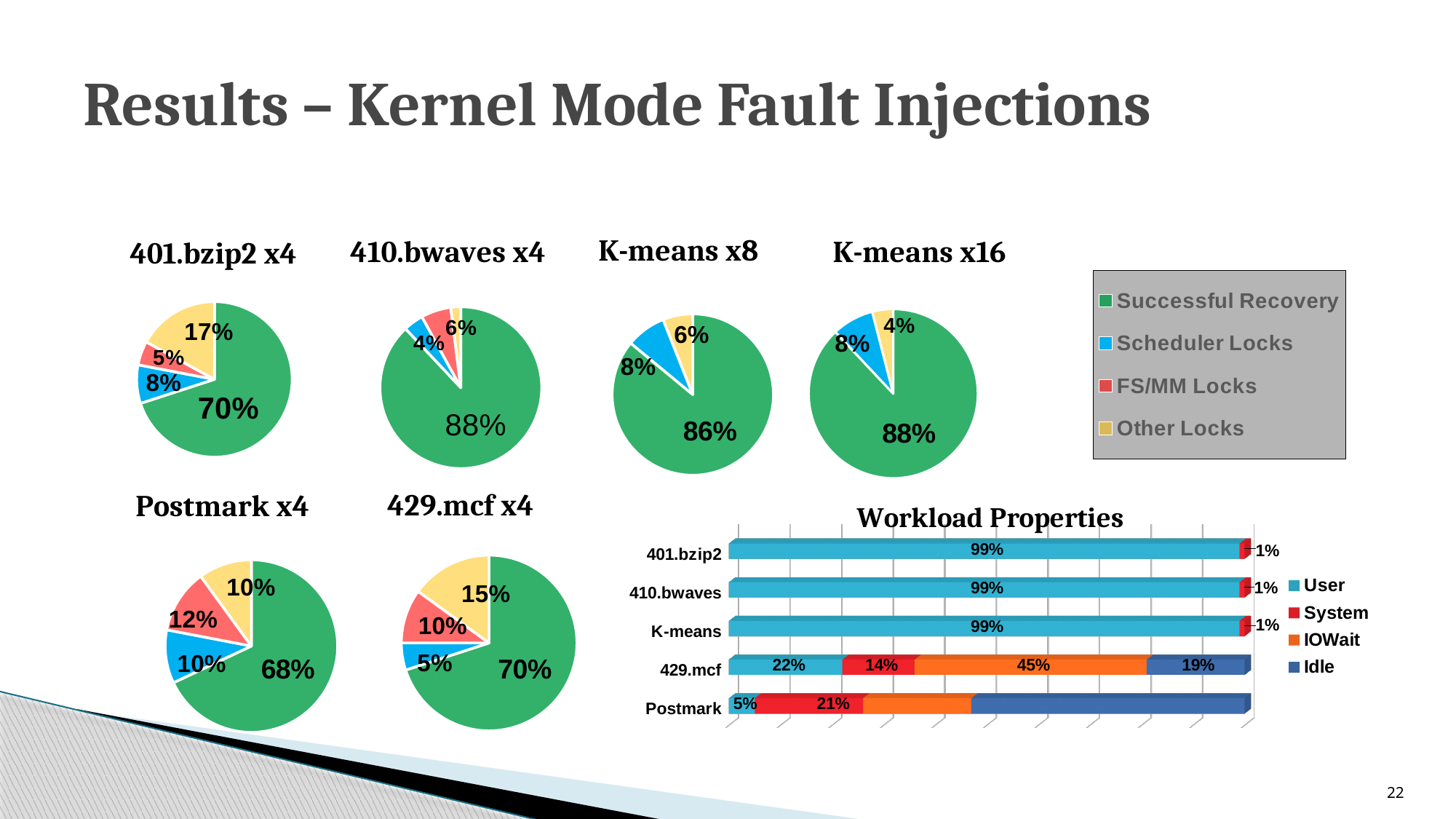
In the Workload Properties chart, what is the System value for Postmark? 21% Which has a larger Successful Recovery share, the K-means x8 pie chart or the K-means x16 pie chart? K-means x16 In the 401.bzip2 x4 pie chart, what share is Successful Recovery? 70% In the Postmark x4 pie chart, what share is FS/MM Locks? 12% What kind of chart is the Workload Properties chart? Bar chart How many workloads are shown in the Workload Properties chart? 5 How many pie charts are on the slide? 6 How many series does the legend of the Workload Properties chart list? 4 In the 401.bzip2 x4 pie chart, how much larger is the Other Locks share than the FS/MM Locks share? 12% In the 429.mcf x4 pie chart, what share is Other Locks? 15% Across the six pie charts, which workload has the lowest Successful Recovery share? Postmark x4 In the Workload Properties chart, what is the IOWait value for 429.mcf? 45%